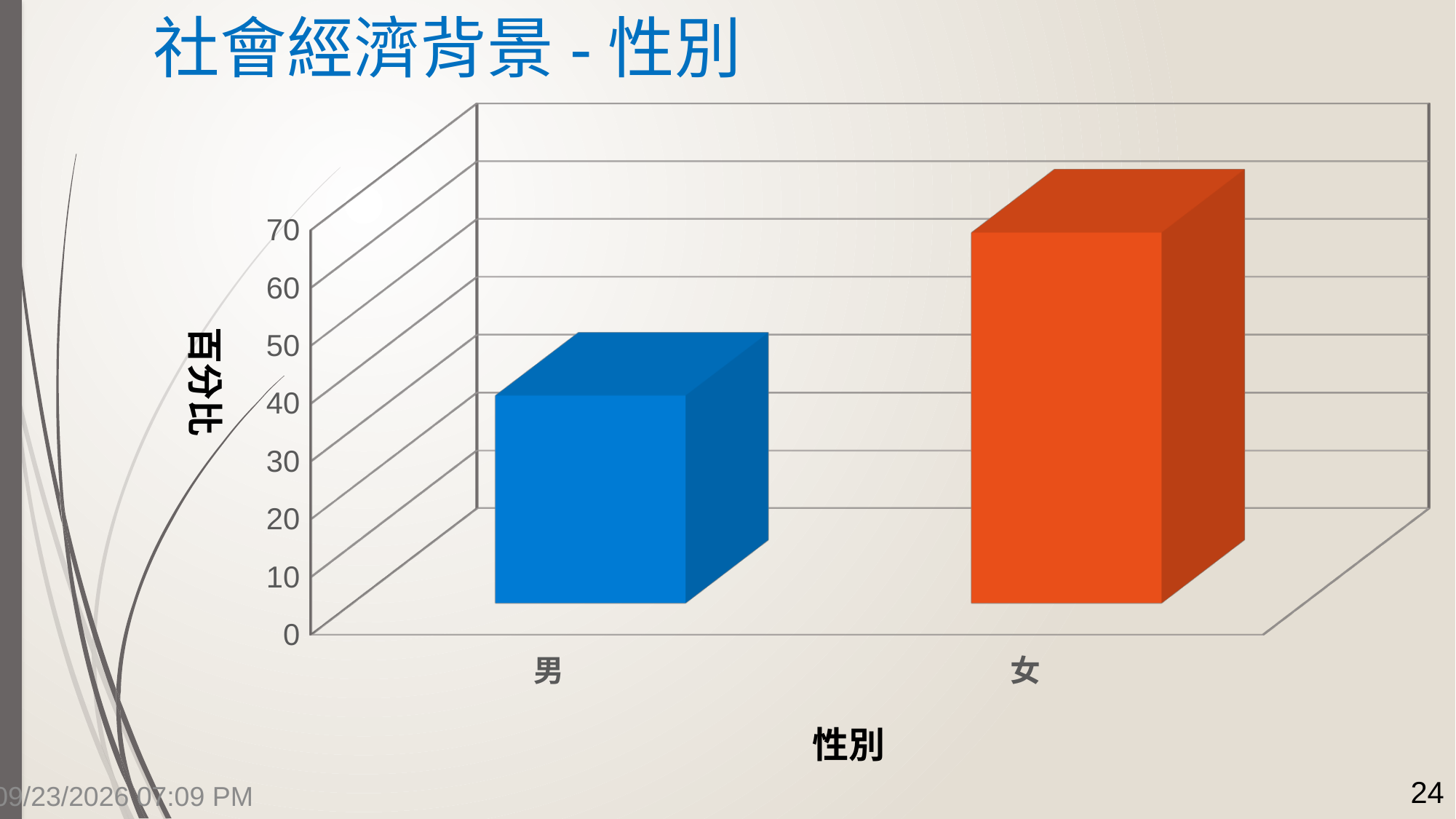
What colour is the bar for 女? orange Which category has the lowest bar in the chart? 男 Is the value for 男 greater or less than 60? less Is the value for 女 greater or less than 60? greater Is the value for 男 greater or less than 30? greater How many categories are shown on the x axis of the chart? 2 What kind of chart is shown on the slide? bar chart Which bar is taller, 男 or 女? 女 What is the title of the y axis of the chart? 百分比 Which category has the highest bar in the chart? 女